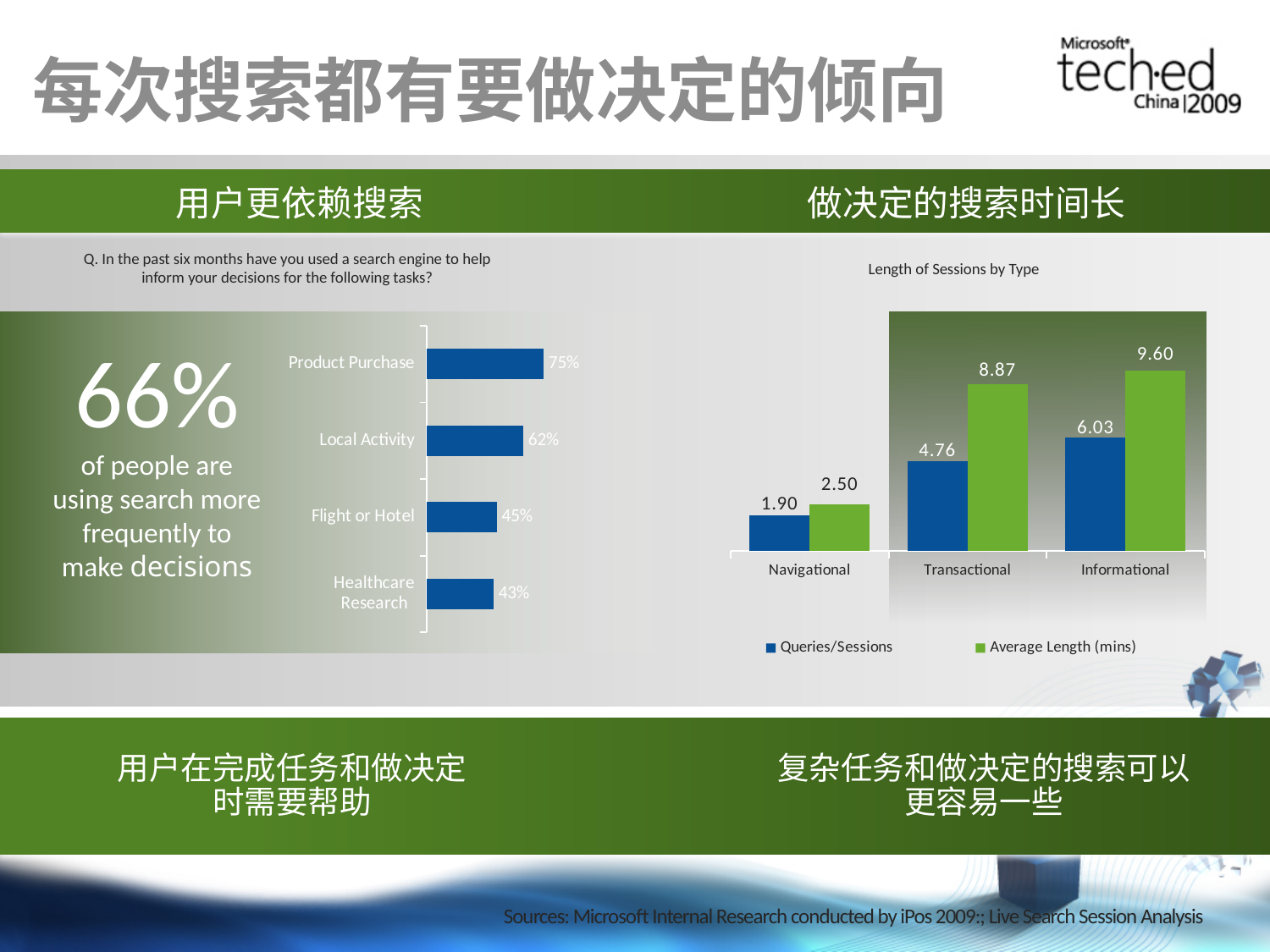
In the 'Length of Sessions by Type' chart, what is the Average Length (mins) for Transactional sessions? 8.87 What kind of chart is the 'Length of Sessions by Type' chart? Bar chart In the left chart, what is the difference between the Local Activity and Flight or Hotel percentages? 17% In the 'Length of Sessions by Type' chart, what is the Queries/Sessions value for Navigational sessions? 1.90 How many series does the legend of the 'Length of Sessions by Type' chart list? 2 In the left chart, how many tasks are listed? 4 In the 'Length of Sessions by Type' chart, what is the difference between the Average Length (mins) for Informational and Transactional sessions? 0.73 In the left chart, which task has the highest percentage? Product Purchase In the left chart, what percentage is shown for Product Purchase? 75% In the 'Length of Sessions by Type' chart, which session type has the lowest Average Length (mins)? Navigational In the 'Length of Sessions by Type' chart, which is larger: Queries/Sessions for Informational or Average Length (mins) for Transactional? Average Length (mins) for Transactional In the left chart, what percentage is shown for Healthcare Research? 43%